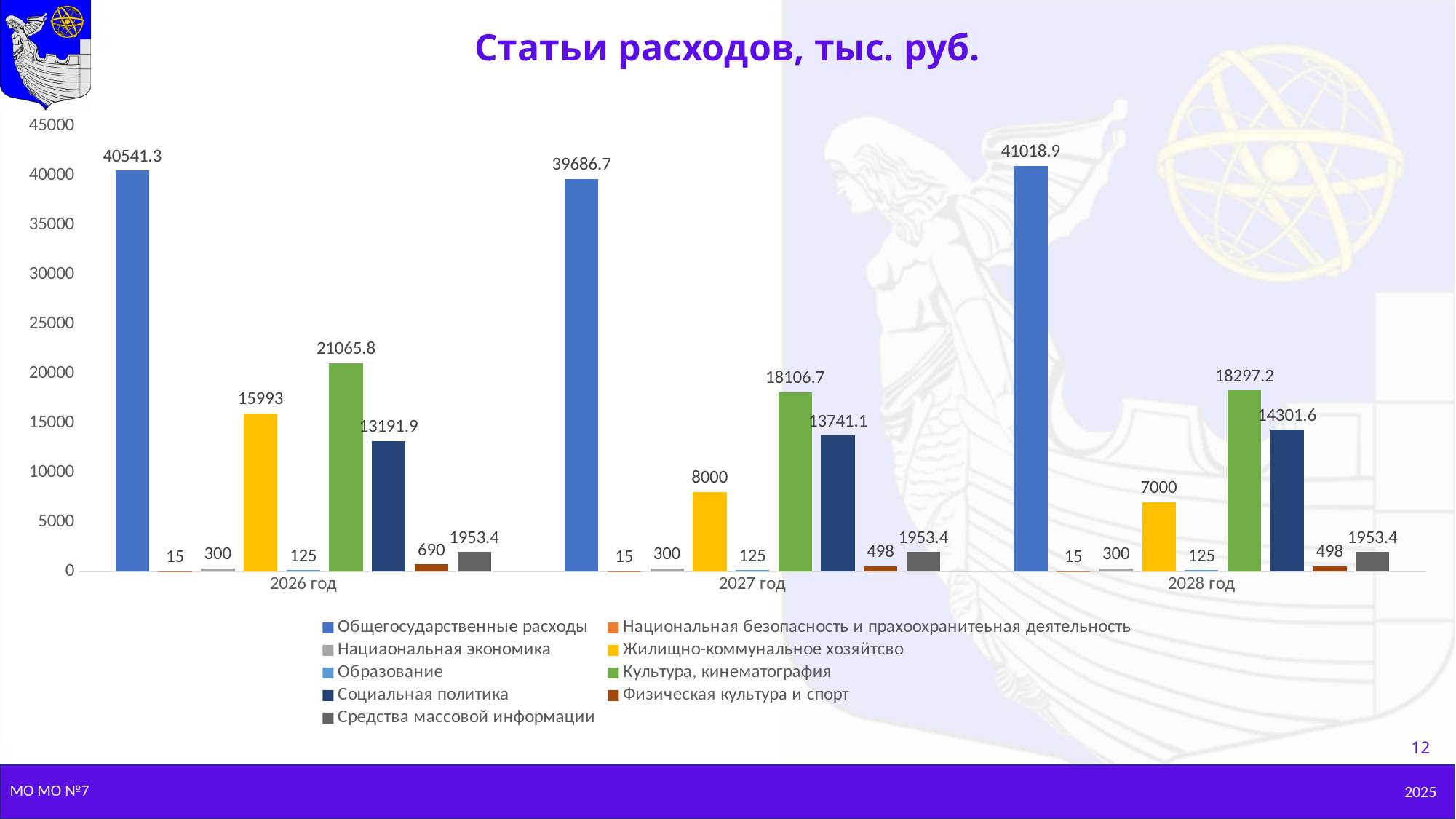
Which is larger: Культура, кинематография in 2026 год or Жилищно-коммунальное хозяйтсво in 2026 год? Культура, кинематография in 2026 год What is the value for Физическая культура и спорт in 2026 год? 690 In which year is Жилищно-коммунальное хозяйтсво lowest? 2028 год What is the title of the chart? Статьи расходов, тыс. руб. How many year categories are shown on the x axis? 3 What kind of chart is shown on the slide? Bar chart How many series does the legend list? 9 What is the value for Культура, кинематография in 2028 год? 18297.2 What is the value for Общегосударственные расходы in 2026 год? 40541.3 What is the value for Жилищно-коммунальное хозяйтсво in 2027 год? 8000 In which year is Общегосударственные расходы highest? 2028 год What is the difference between Социальная политика in 2028 год and in 2027 год? 560.5